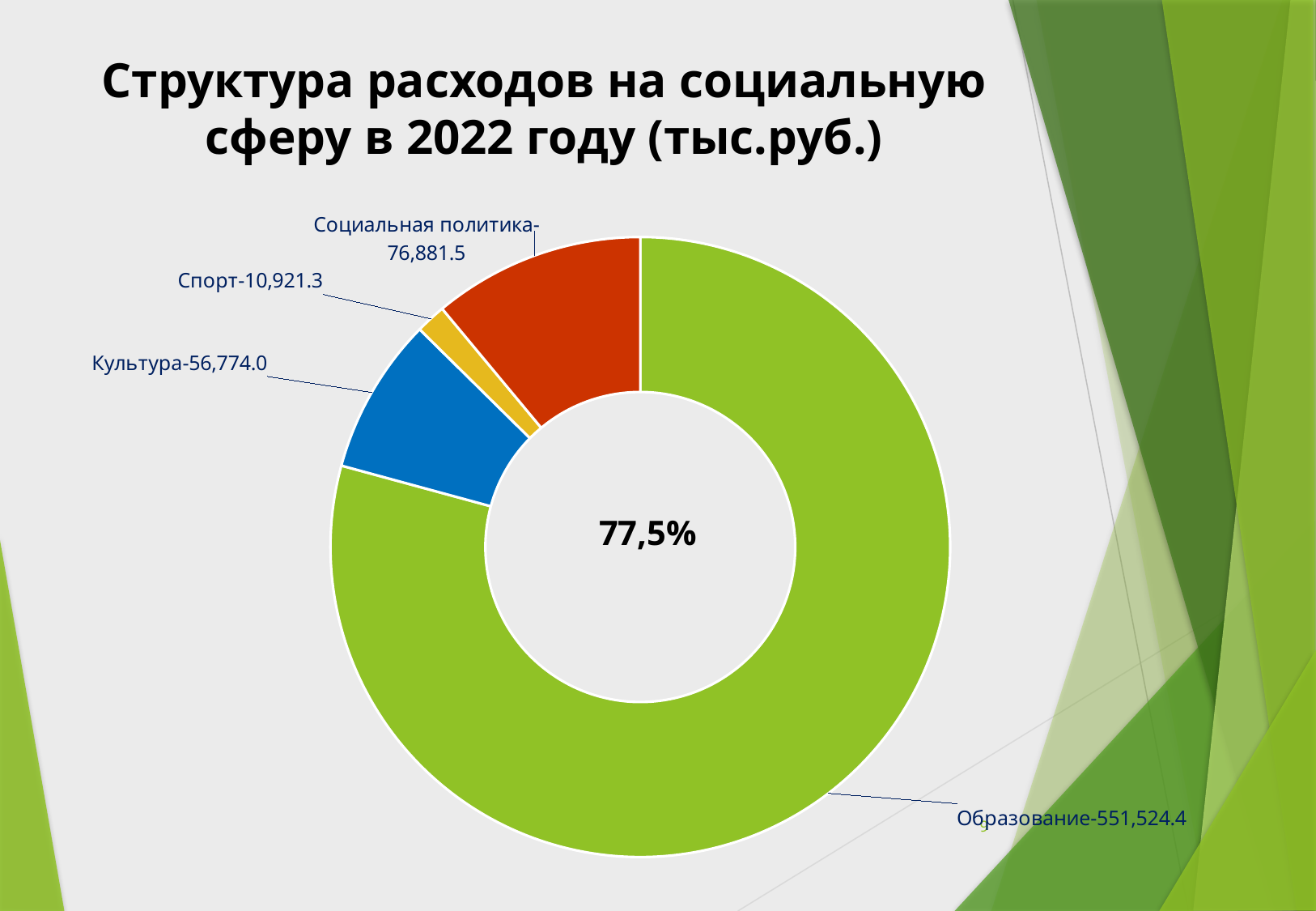
What is the value for Культура? 56,774.0 What is the difference between the values for Культура and Спорт? 45,852.7 Which category has the smallest value? Спорт What is the difference between the values for Социальная политика and Культура? 20,107.5 How many categories are shown in the chart? 4 Which category has the largest value? Образование What is the value for Социальная политика? 76,881.5 What kind of chart is shown on the slide? Doughnut (pie) chart What is the value for Спорт? 10,921.3 What is the value for Образование? 551,524.4 What percentage is printed in the centre of the doughnut chart? 77,5% Which is larger, the value for Социальная политика or the value for Культура? Социальная политика